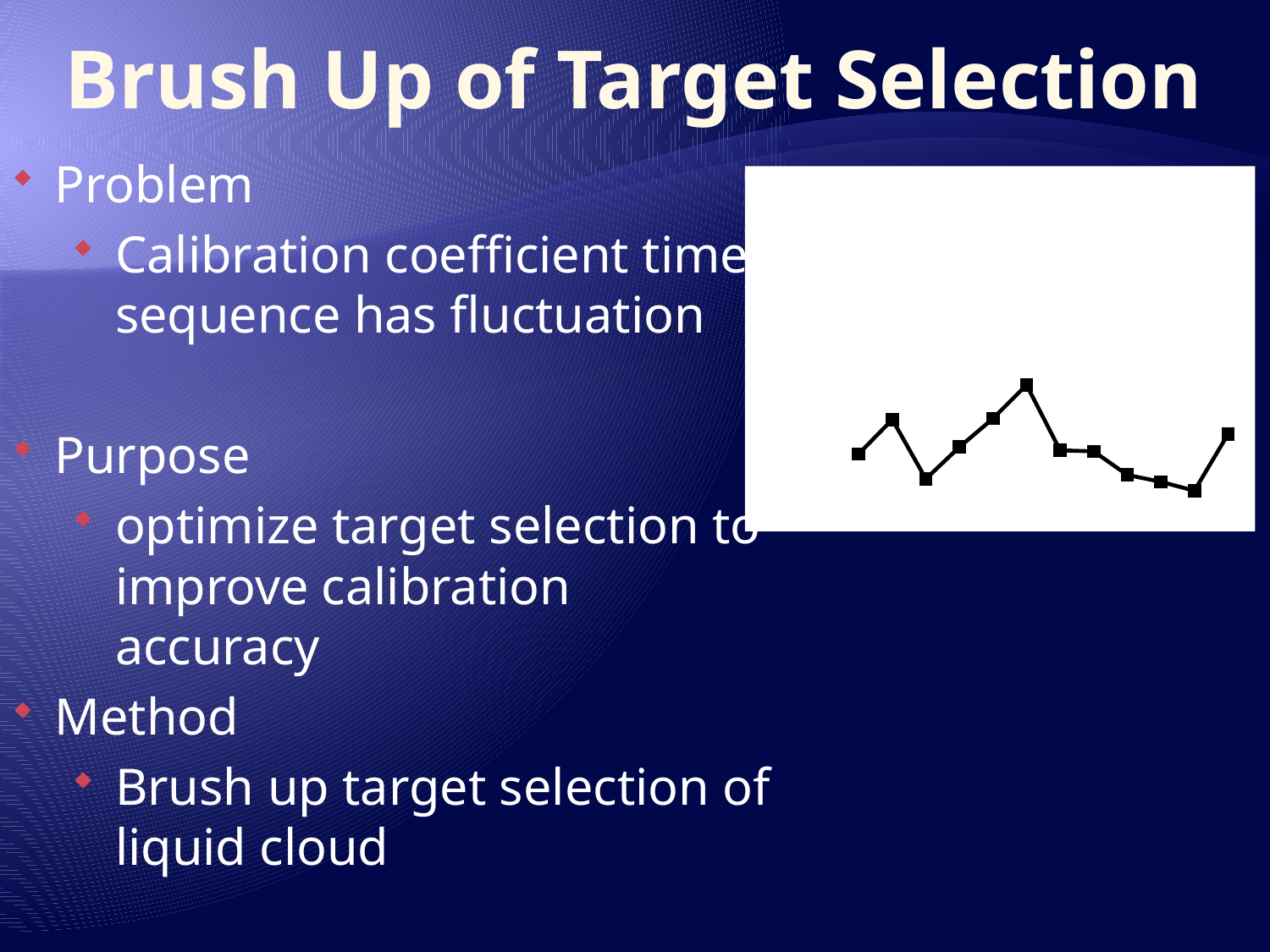
On the line chart, is the last (rightmost) point higher or lower than the first (leftmost) point? higher Does the line chart display any axis labels or a title? No What shape are the data markers on the line chart? squares What kind of chart is shown on the right side of the slide? line chart How many data points are plotted on the line chart? 12 On the line chart, is the 2nd point from the left higher or lower than the 3rd point? higher How many series does the line chart plot? 1 Does the line chart show a steady rise, a steady fall, or fluctuation along the x axis? fluctuation Counting from the left, which data point on the line chart is the highest? the 6th point Counting from the left, which data point on the line chart is the lowest? the 11th point